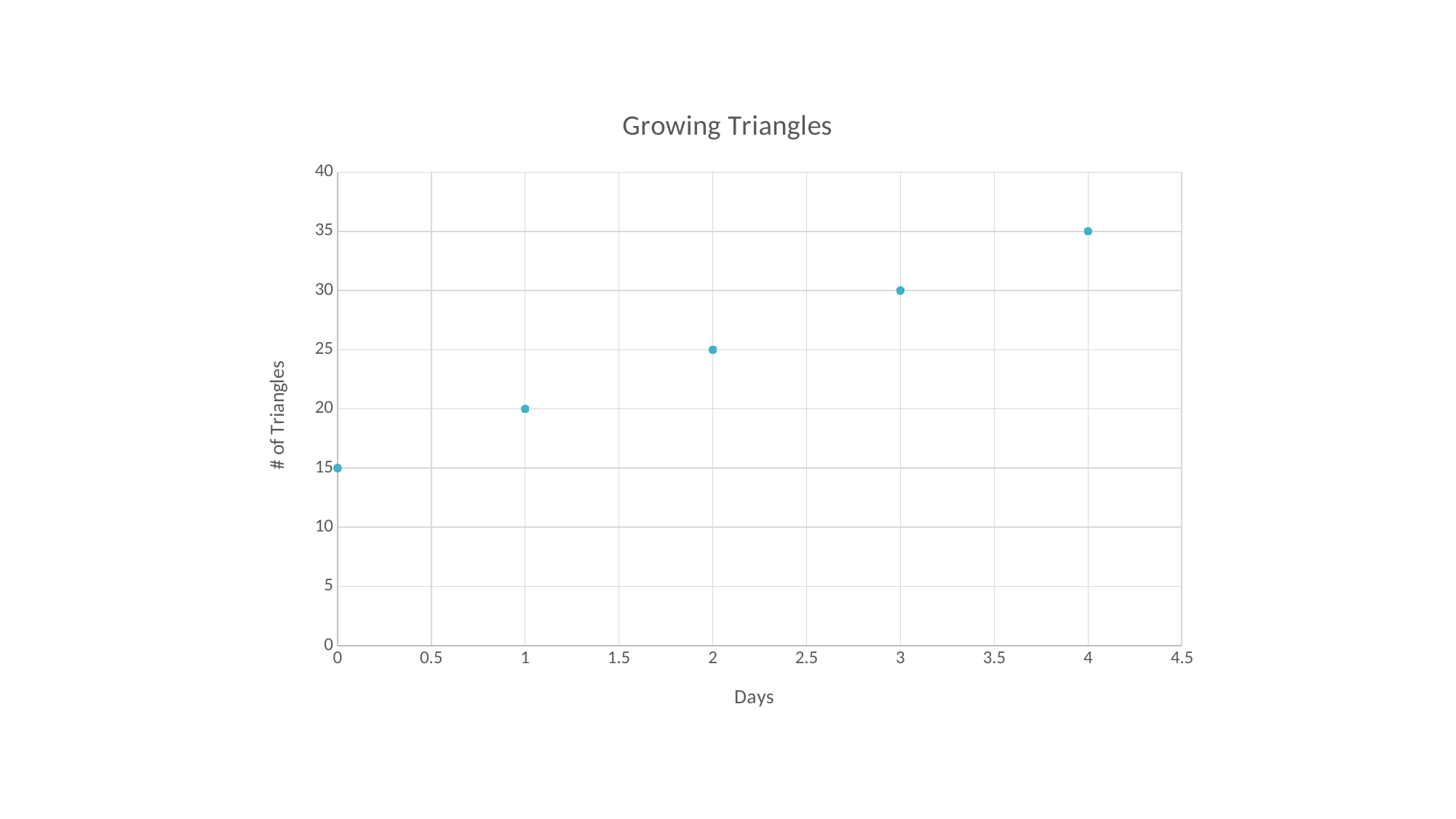
What type of chart is shown on the slide? scatter plot Which has more triangles, day 1 or day 3? day 3 Do the values rise or fall as the days increase? rise At which day is the number of triangles lowest? 0 What is the number of triangles at day 4? 35 What is the number of triangles at day 0? 15 How many data points are plotted on the chart? 5 What is the label of the y axis? # of Triangles What is the difference in the number of triangles between day 3 and day 1? 10 What is the title of the chart? Growing Triangles At which day is the number of triangles highest? 4 What is the number of triangles at day 2? 25